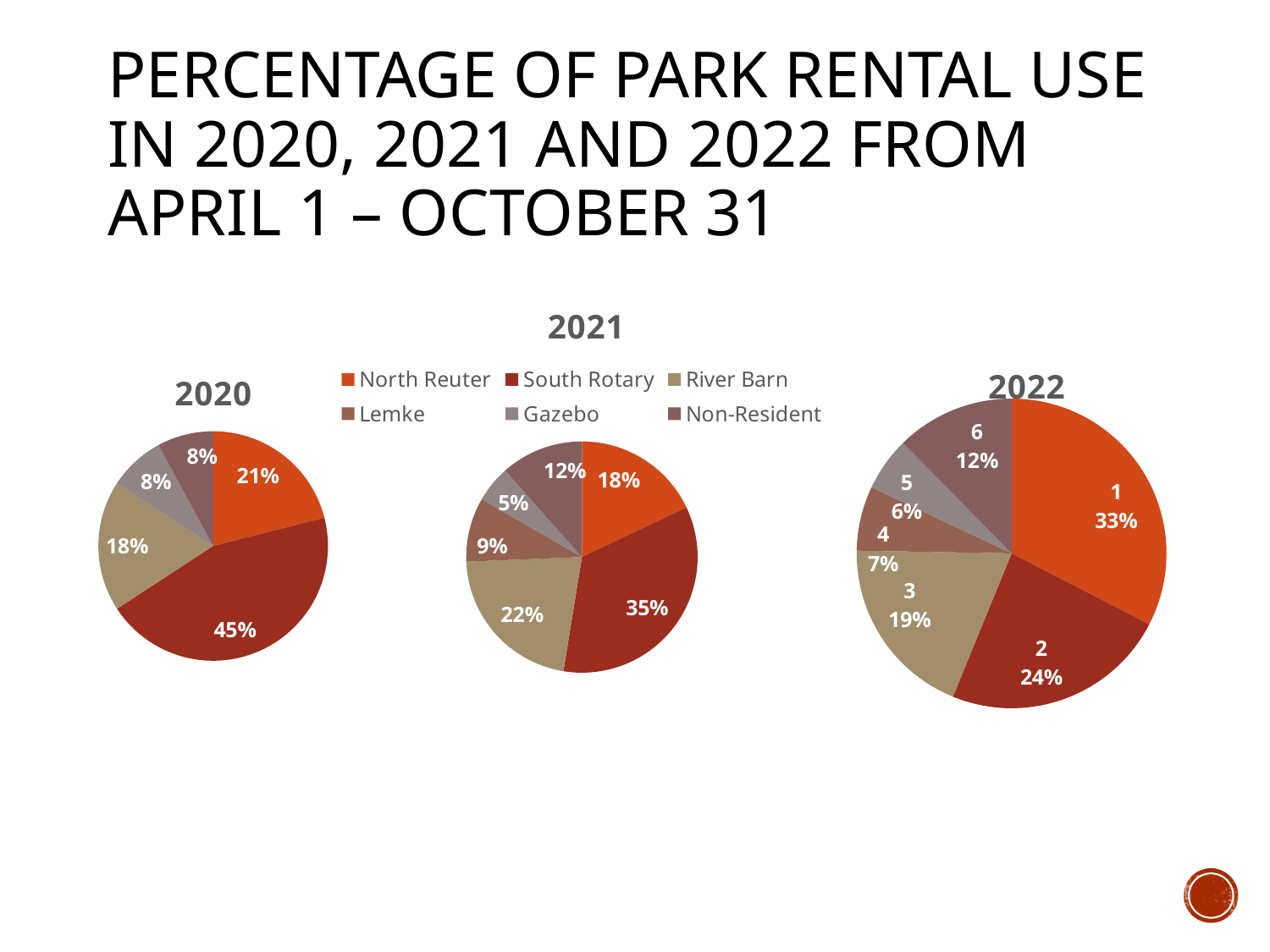
In the 2021 pie chart, what percentage is shown for River Barn? 22% In the 2021 pie chart, which is larger, the North Reuter share or the River Barn share? River Barn In the 2020 pie chart, what percentage is shown for North Reuter? 21% In the 2022 pie chart, what percentage is shown for the slice labeled 3? 19% In the 2021 pie chart, what percentage is shown for Non-Resident? 12% How many categories does the legend list? 6 What type of chart is used for the 2022 data? Pie chart In the 2020 pie chart, what is the difference between the South Rotary share and the North Reuter share? 24% In the 2021 pie chart, which category has the smallest share? Gazebo In the 2020 pie chart, what percentage is shown for South Rotary? 45% In the 2021 pie chart, which category has the largest share? South Rotary In the 2022 pie chart, what percentage is shown for the slice labeled 1? 33%